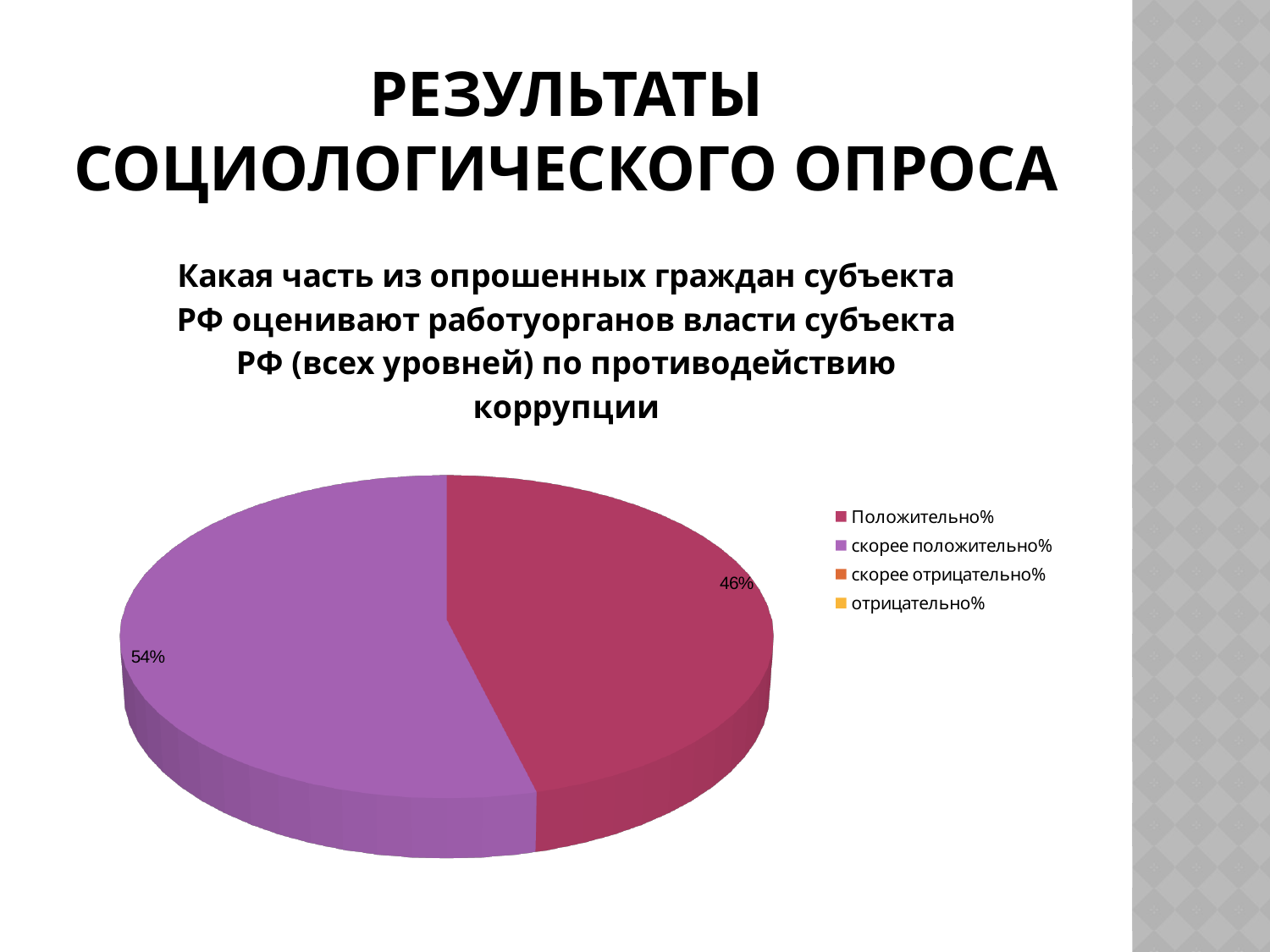
What is the difference in percentage points between the "скорее положительно%" slice and the "Положительно%" slice? 8 Which is larger: the "Положительно%" slice or the "скорее положительно%" slice? скорее положительно% What share of the pie does the "Положительно%" slice represent? 46% How many entries does the legend of the pie chart list? 4 How many slices are visible in the pie chart? 2 Which of the two visible slices is smaller, "Положительно%" or "скорее положительно%"? Положительно% Which slice is the largest in the pie chart? скорее положительно% What is the total of the two labelled slices in the pie chart? 100% What colour is the "скорее положительно%" slice in the pie chart? purple What share of the pie does the "скорее положительно%" slice represent? 54% What kind of chart is shown on the slide? pie chart Which legend entry is listed last in the pie chart's legend? отрицательно%